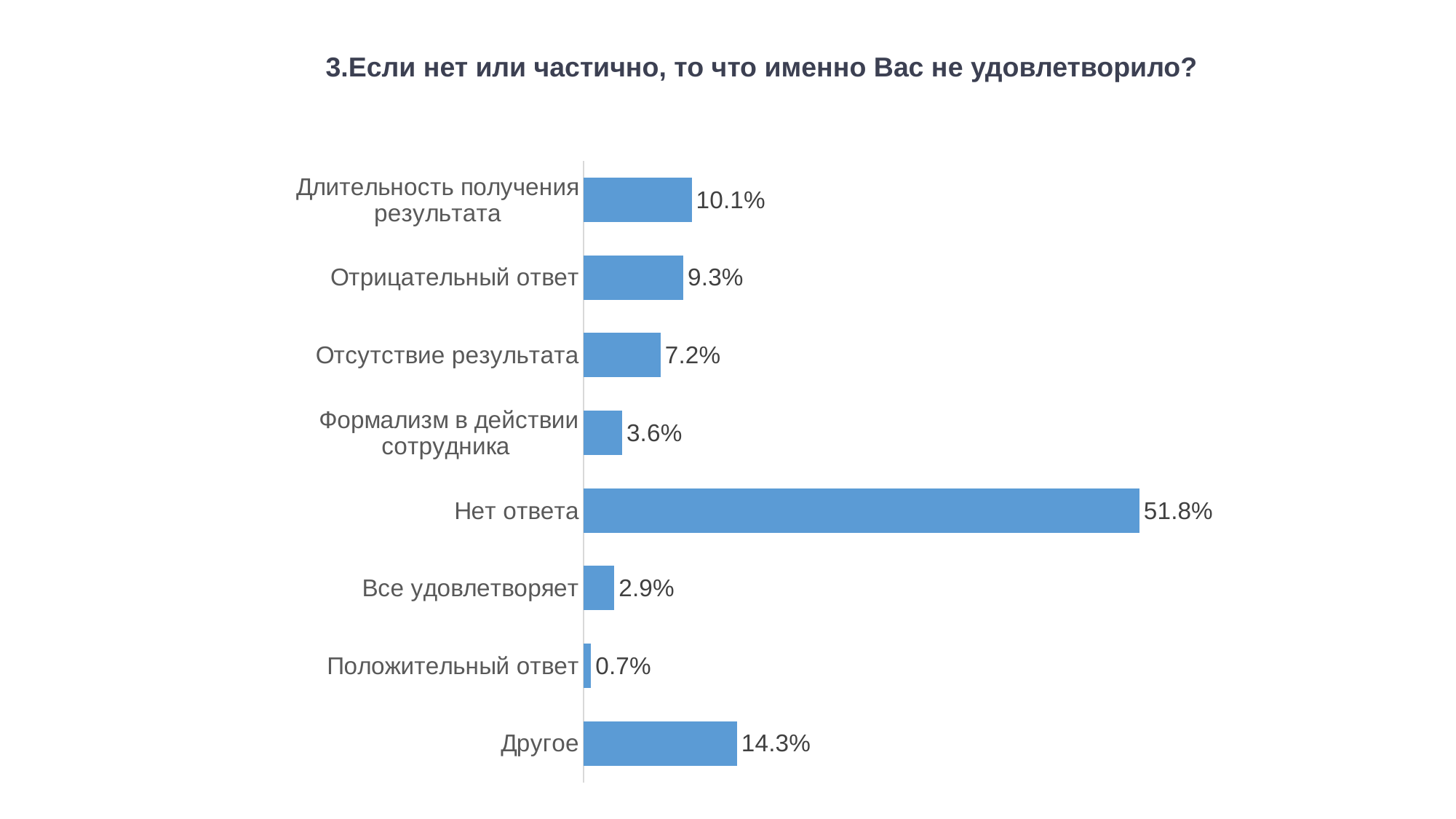
What is the value for "Длительность получения результата"? 10.1% Which is larger, the value for "Все удовлетворяет" or the value for "Формализм в действии сотрудника"? Формализм в действии сотрудника What is the value for "Формализм в действии сотрудника"? 3.6% Which category has the highest value? Нет ответа How many categories are shown in the chart? 8 Which category has the lowest value? Положительный ответ What is the value for "Нет ответа"? 51.8% What is the difference between the values for "Отрицательный ответ" and "Отсутствие результата"? 2.1% What kind of chart is shown on the slide? Bar chart What is the title of the chart? 3.Если нет или частично, то что именно Вас не удовлетворило? What is the value for "Другое"? 14.3% What is the difference between the values for "Другое" and "Длительность получения результата"? 4.2%